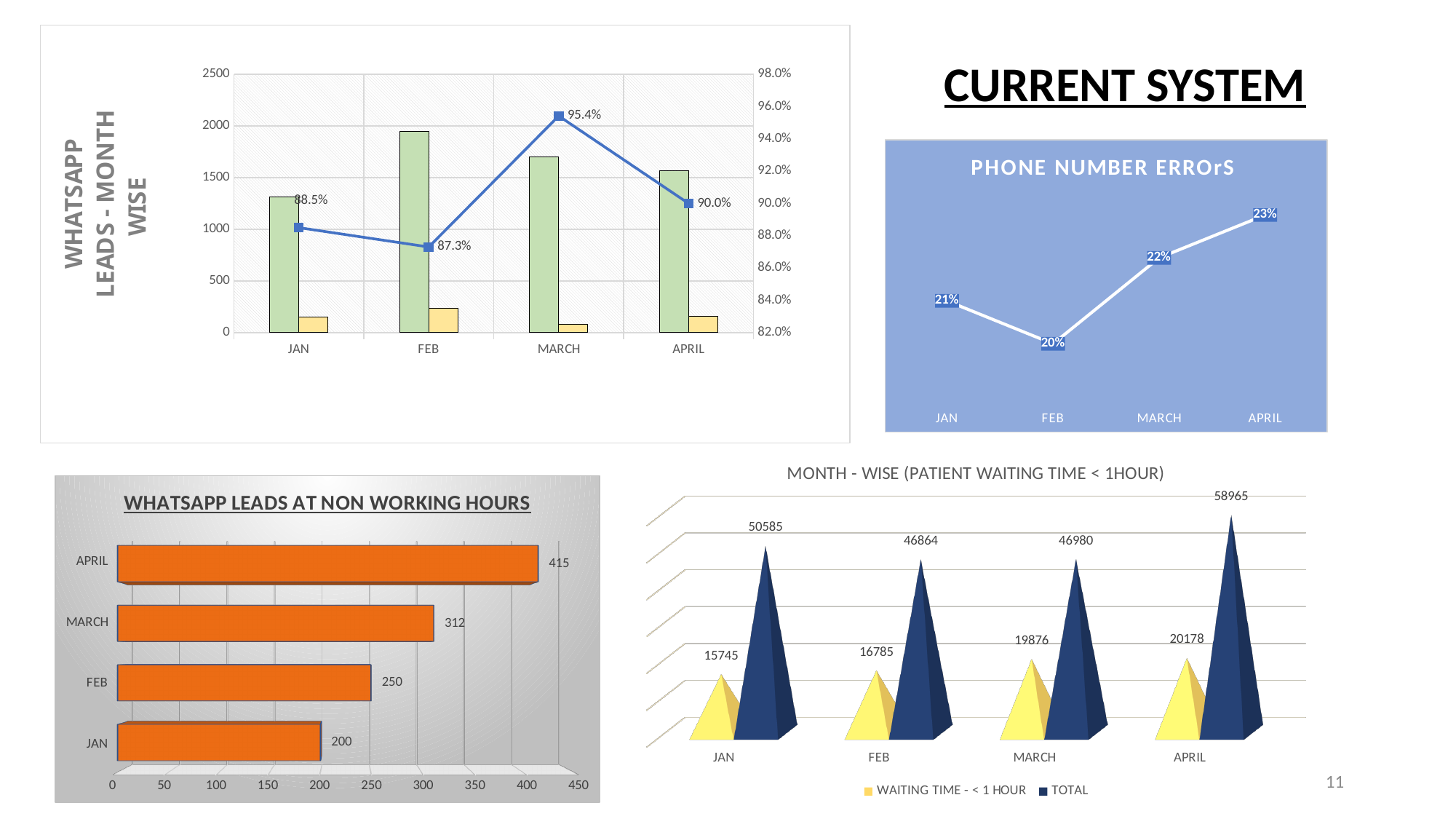
In the MONTH - WISE (PATIENT WAITING TIME < 1HOUR) chart, what is the WAITING TIME - < 1 HOUR value for MARCH? 19876 How many series does the legend of the MONTH - WISE (PATIENT WAITING TIME < 1HOUR) chart list? 2 In the WHATSAPP LEADS - MONTH WISE chart, is the green bar for FEB greater or less than 1500? greater In the WHATSAPP LEADS AT NON WORKING HOURS chart, what is the difference between APRIL and JAN? 215 In the WHATSAPP LEADS - MONTH WISE chart, what percentage is shown on the line for MARCH? 95.4% In the MONTH - WISE (PATIENT WAITING TIME < 1HOUR) chart, what is the TOTAL value for APRIL? 58965 In the WHATSAPP LEADS AT NON WORKING HOURS chart, what is the value for MARCH? 312 In the WHATSAPP LEADS - MONTH WISE chart, which month has the lowest percentage on the line? FEB What type of chart is WHATSAPP LEADS AT NON WORKING HOURS? Bar chart In the WHATSAPP LEADS AT NON WORKING HOURS chart, do the values rise or fall from JAN to APRIL? Rise In the PHONE NUMBER ERRORS chart, which month has the highest value? APRIL In the PHONE NUMBER ERRORS chart, what is the value for FEB? 20%